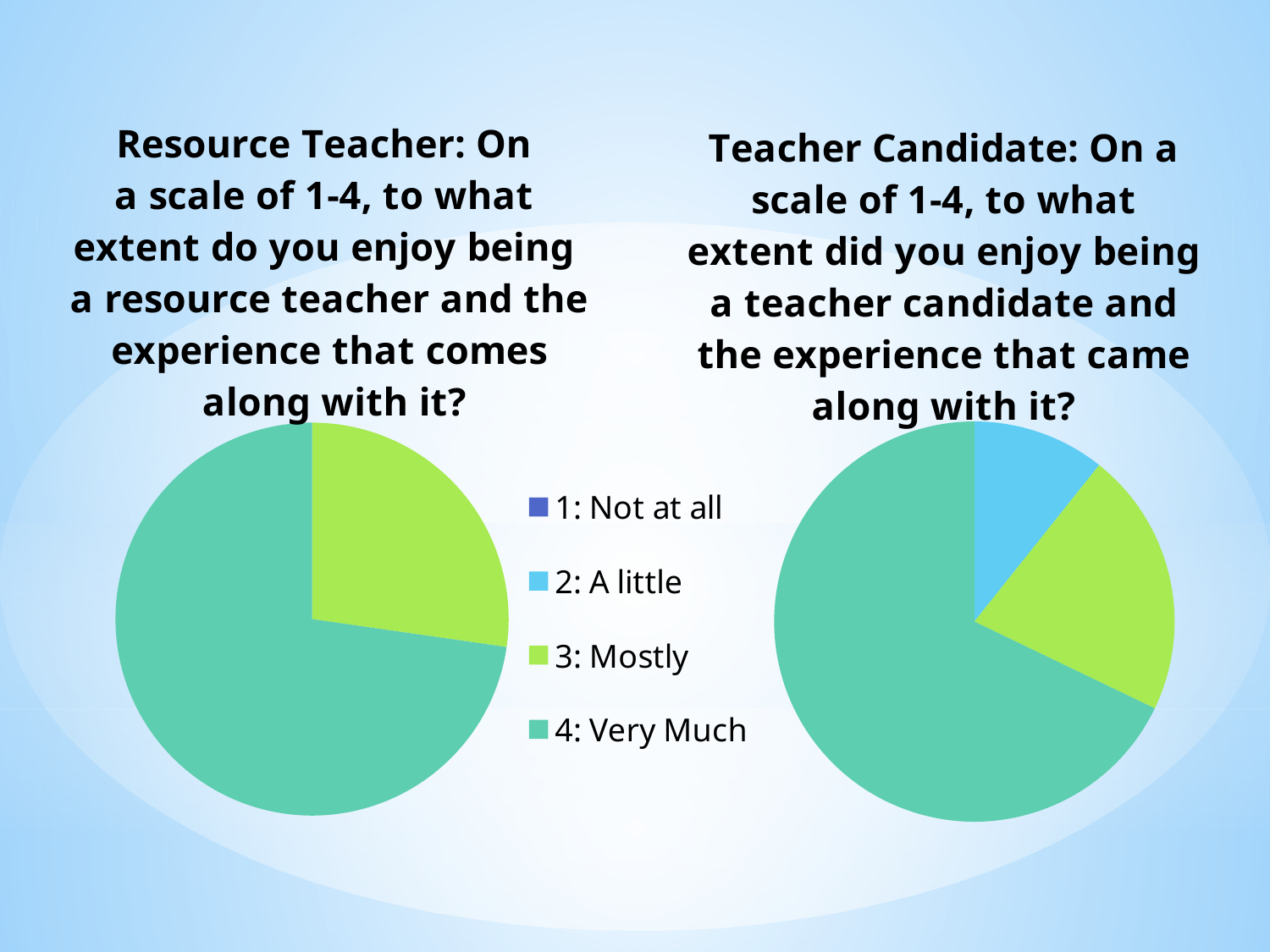
What colour represents the category 3: Mostly in the legend? Light green In the Resource Teacher pie chart on the left, which category has the largest slice? 4: Very Much In the Teacher Candidate pie chart on the right, which of the visible categories has the smallest slice? 2: A little How many entries does the shared legend between the two pie charts list? 4 How many slices are visible in the Teacher Candidate pie chart on the right? 3 What kind of chart is used on the right side of the slide, under the Teacher Candidate question? Pie chart In the Resource Teacher pie chart on the left, which slice is larger: 3: Mostly or 4: Very Much? 4: Very Much What kind of chart is used on the left side of the slide, under the Resource Teacher question? Pie chart How many slices are visible in the Resource Teacher pie chart on the left? 2 In the Teacher Candidate pie chart on the right, which slice is larger: 2: A little or 3: Mostly? 3: Mostly Which legend category does not appear as a visible slice in either pie chart? 1: Not at all In the Teacher Candidate pie chart on the right, which category has the largest slice? 4: Very Much